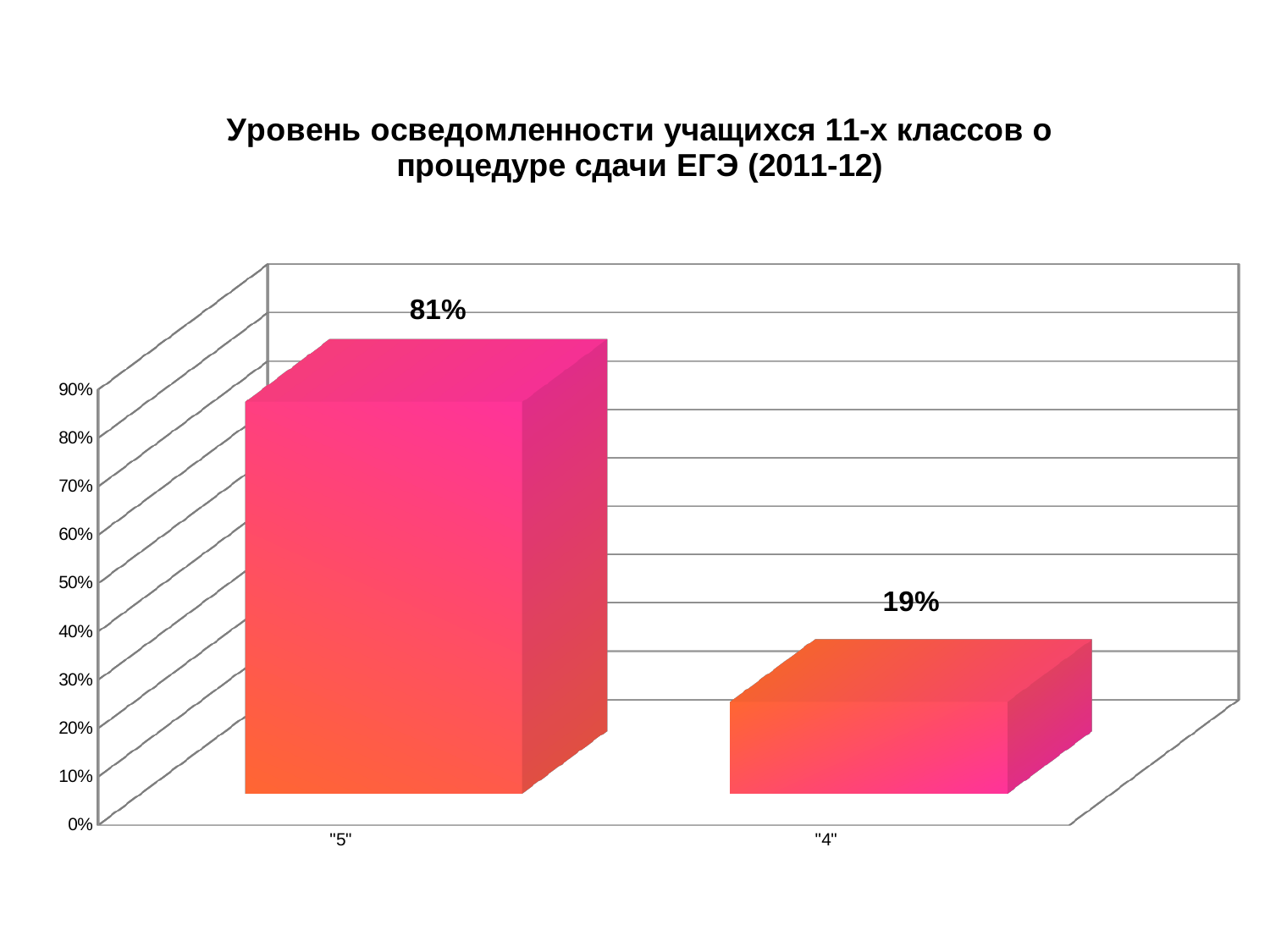
What is the value for category "4"? 19% How many categories are shown on the x axis? 2 Which category has the highest value? "5" What is the total of the two values shown? 100% Is the value for "5" greater or less than 70%? greater Which is larger, the value for "5" or the value for "4"? "5" What kind of chart is shown on the slide? bar chart Which category has the lowest value? "4" What is the title of the chart? Уровень осведомленности учащихся 11-х классов о процедуре сдачи ЕГЭ (2011-12) What is the difference between the values for "5" and "4"? 62% Is the value for "4" greater or less than 30%? less What is the value for category "5"? 81%